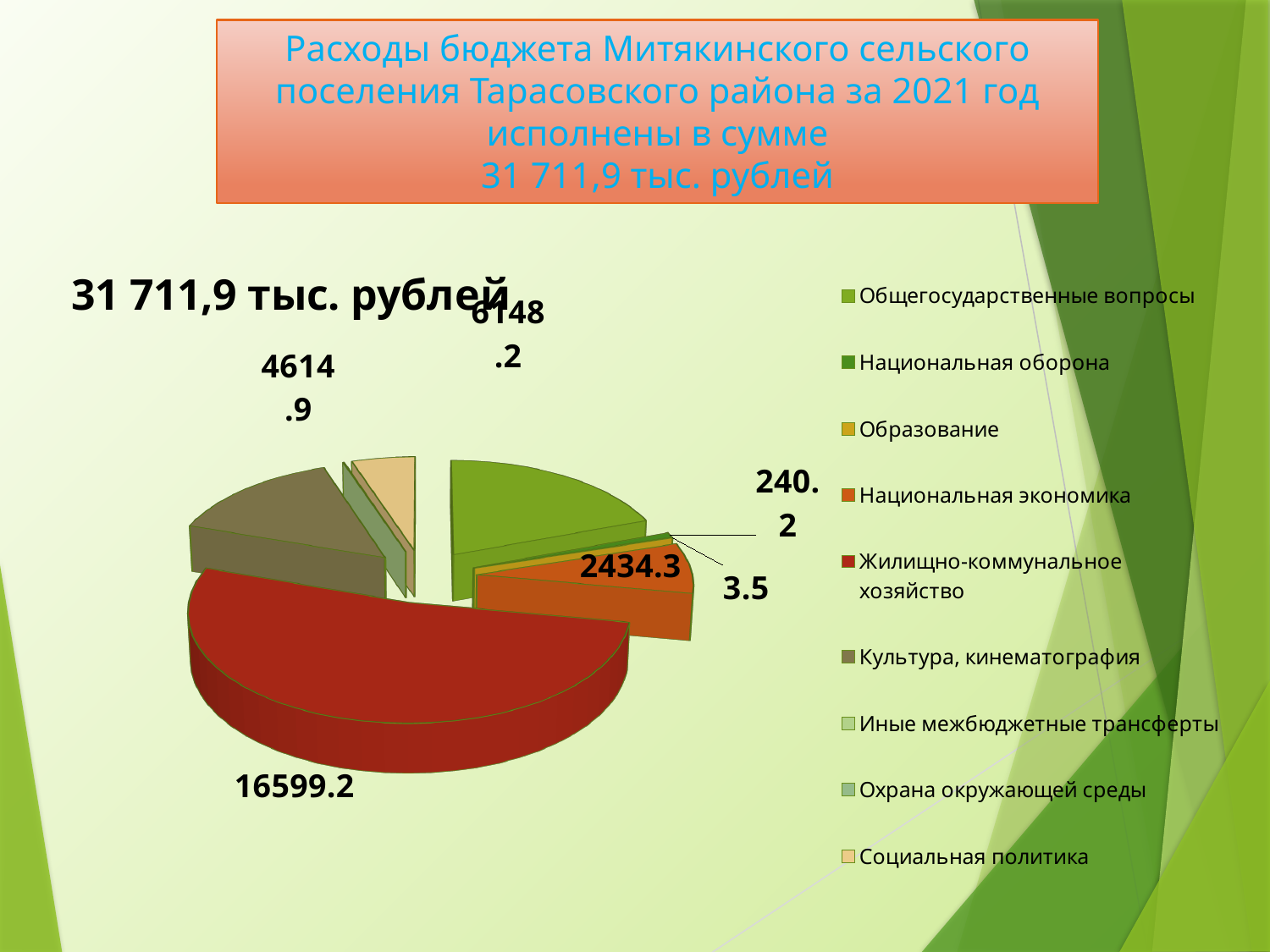
How many categories does the legend of the pie chart list? 9 Which category has the largest slice in the pie chart? Жилищно-коммунальное хозяйство What is the value for Культура, кинематография in the pie chart? 4614.9 What is the difference between the values for Жилищно-коммунальное хозяйство and Общегосударственные вопросы? 10451 What is the value for Национальная экономика in the pie chart? 2434.3 What is the value for Жилищно-коммунальное хозяйство in the pie chart? 16599.2 Which is larger in the pie chart: Общегосударственные вопросы or Культура, кинематография? Общегосударственные вопросы What is the difference between the values for Общегосударственные вопросы and Культура, кинематография? 1533.3 What is the title shown above the pie chart? 31 711,9 тыс. рублей What is the value for Общегосударственные вопросы in the pie chart? 6148.2 What colour is the slice for Жилищно-коммунальное хозяйство in the pie chart? red What type of chart is shown on the slide? pie chart